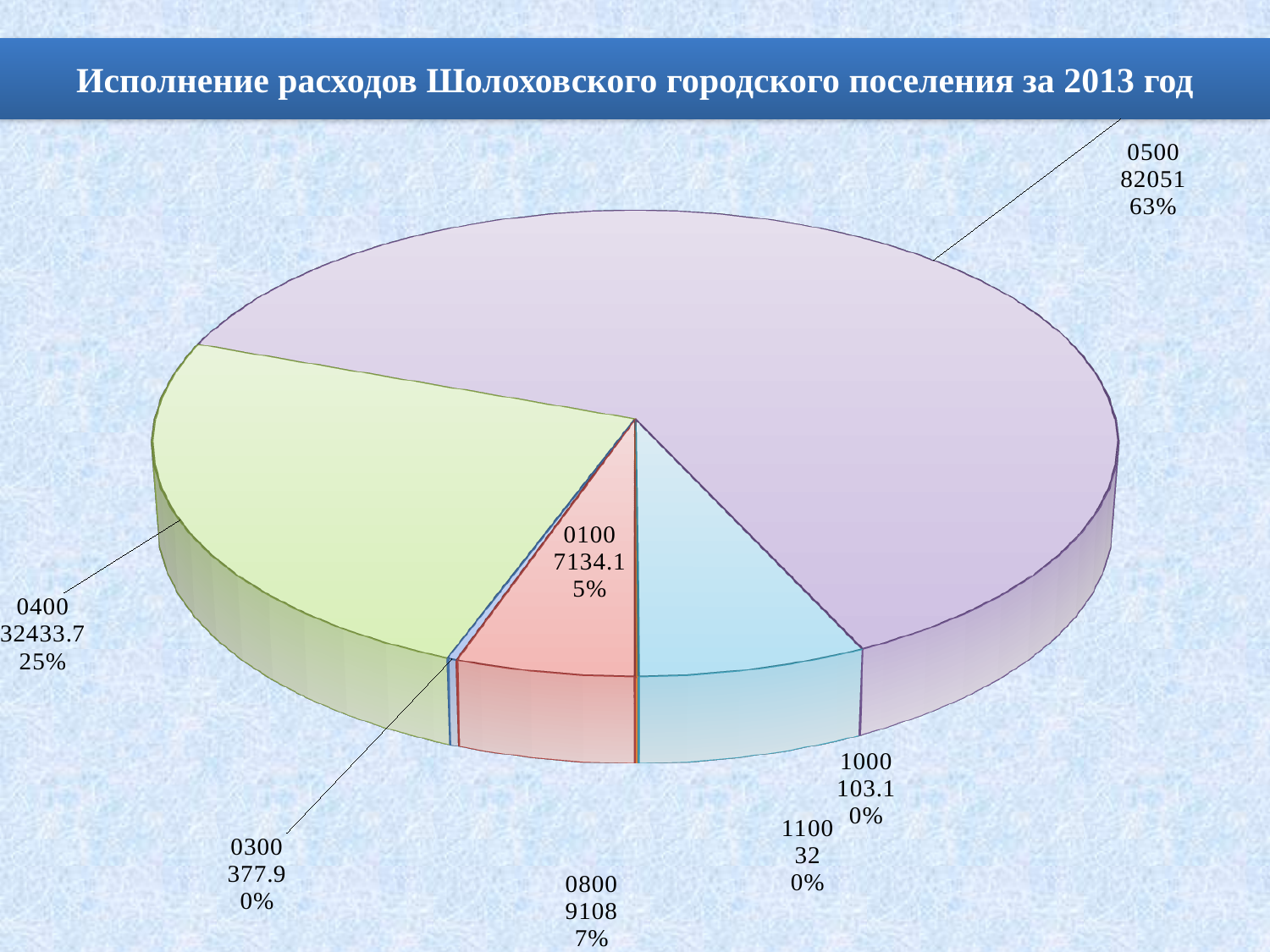
How many categories are shown in the pie chart? 7 What is the value for category 0400? 32433.7 Which category has the largest slice of the pie? 0500 What share of the pie does category 0100 represent? 5% Which category has the smallest value? 1100 What share of the pie does category 0500 represent? 63% What is the value for category 0500? 82051 What is the value for category 0800? 9108 What kind of chart is shown on the slide? pie chart What is the difference between the values for 0500 and 0400? 49617.3 What is the value for category 0300? 377.9 Which is larger, the value for 0800 or the value for 0100? 0800